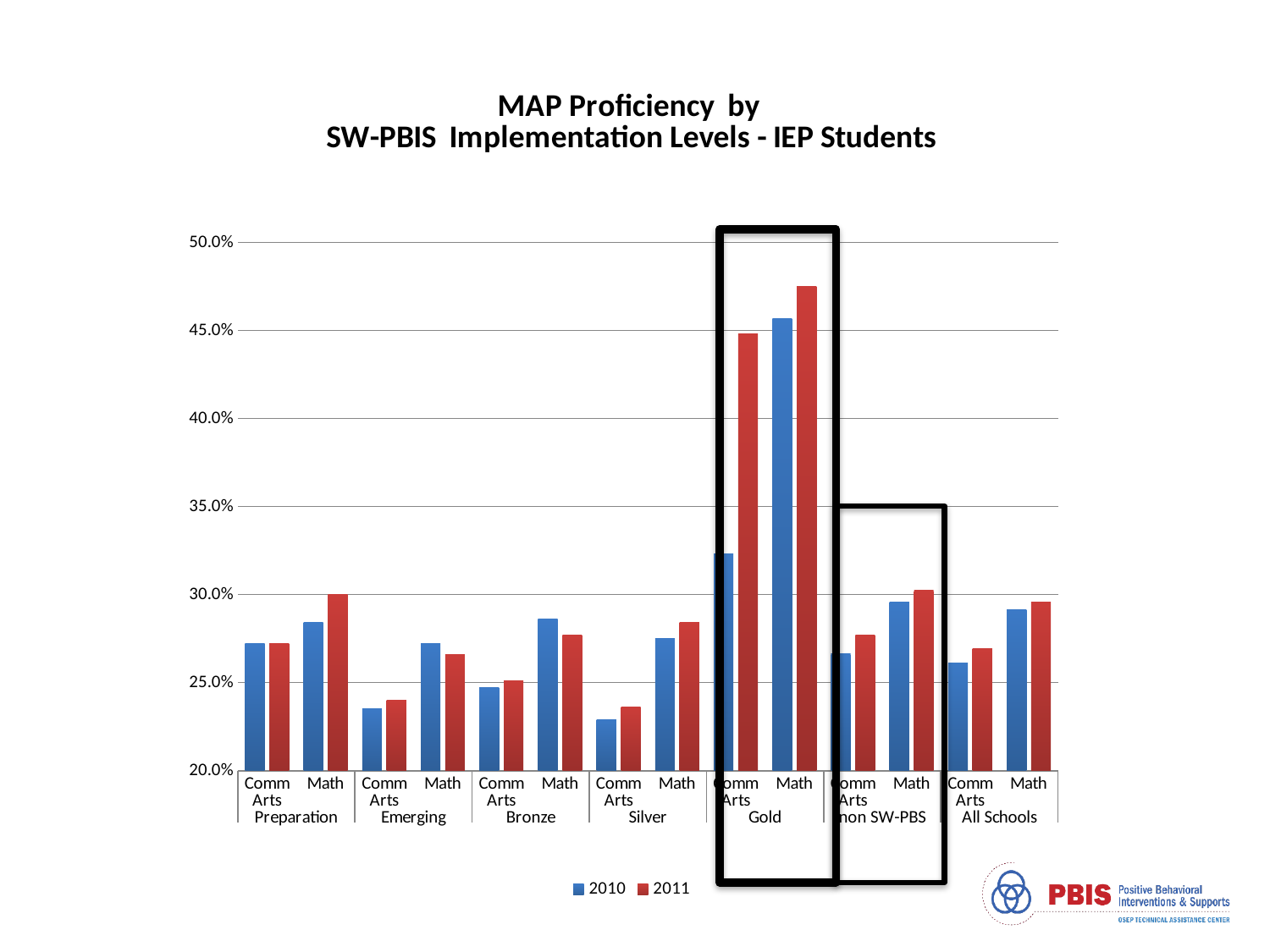
Is the 2010 Comm Arts value for Emerging greater or less than 25.0%? less How many series does the legend list? 2 How many implementation level groups are shown along the x axis? 7 Which bar is the highest in the chart? Gold Math 2011 For Gold Comm Arts, which year has the larger value, 2010 or 2011? 2011 Is the 2011 Math value for Gold greater or less than 45.0%? greater Is the 2010 Comm Arts value for Silver greater or less than 25.0%? less For Bronze Math, which year has the larger value, 2010 or 2011? 2010 What are the two series named in the legend? 2010 and 2011 What kind of chart is shown on the slide? bar chart Which bar is the lowest in the chart? Silver Comm Arts 2010